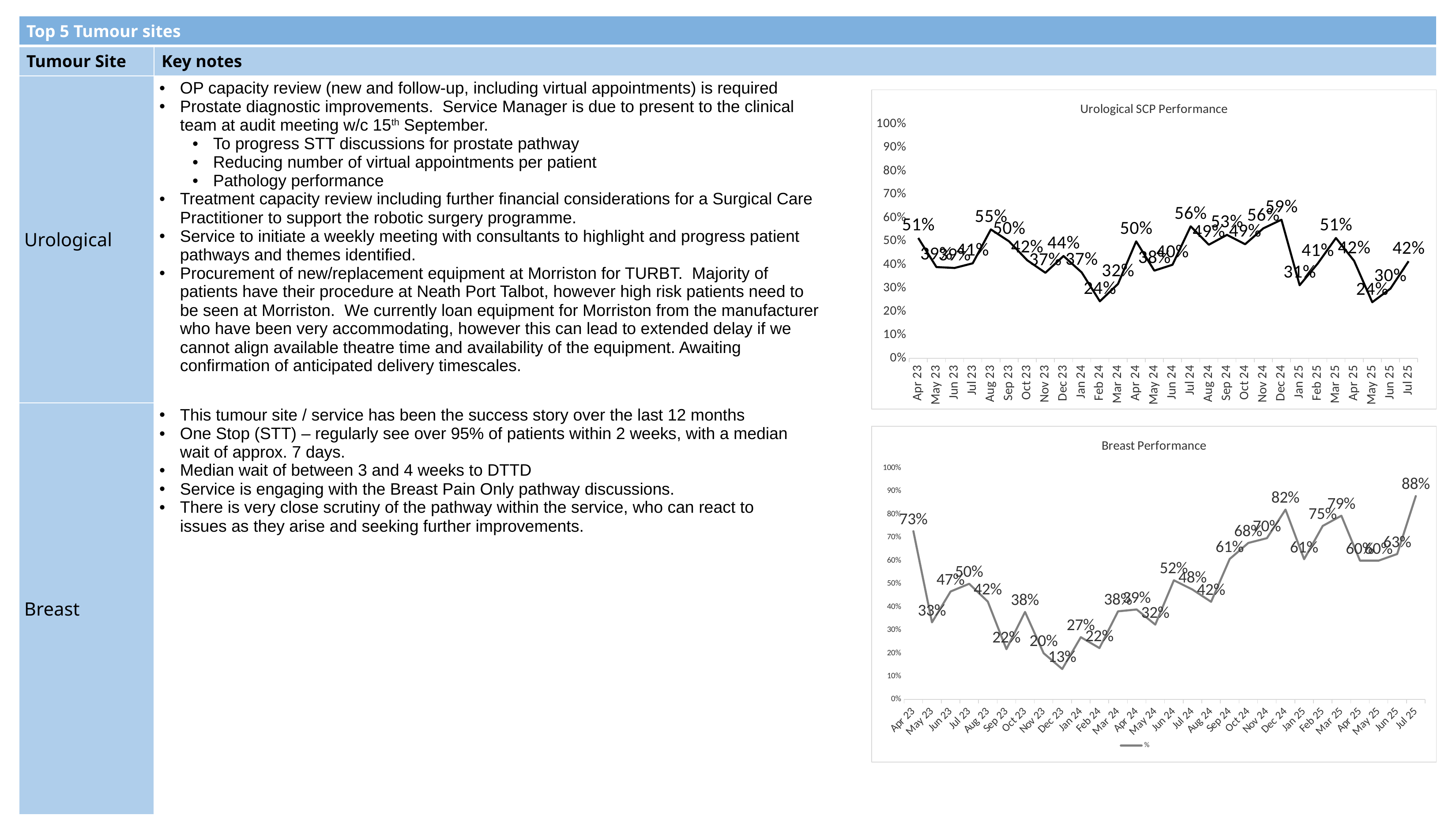
In the Breast Performance chart, which month has the lowest value? Dec 23 In the Breast Performance chart, which month has the highest value? Jul 25 How many monthly data points are plotted in the Breast Performance chart? 28 What is the legend entry shown below the Breast Performance chart? % What type of chart is the Urological SCP Performance chart? Line chart In the Urological SCP Performance chart, what is the value for Apr 23? 51% In the Breast Performance chart, what is the value for Dec 24? 82% In the Urological SCP Performance chart, what is the value for Jul 25? 42% In the Breast Performance chart, what is the difference between the Jul 25 value and the Apr 23 value? 15% In the Urological SCP Performance chart, which is larger, the value for Mar 25 or the value for Jan 25? Mar 25 In the Urological SCP Performance chart, which month has the highest value? Dec 24 In the Urological SCP Performance chart, what is the difference between the Aug 23 value and the Feb 24 value? 31%